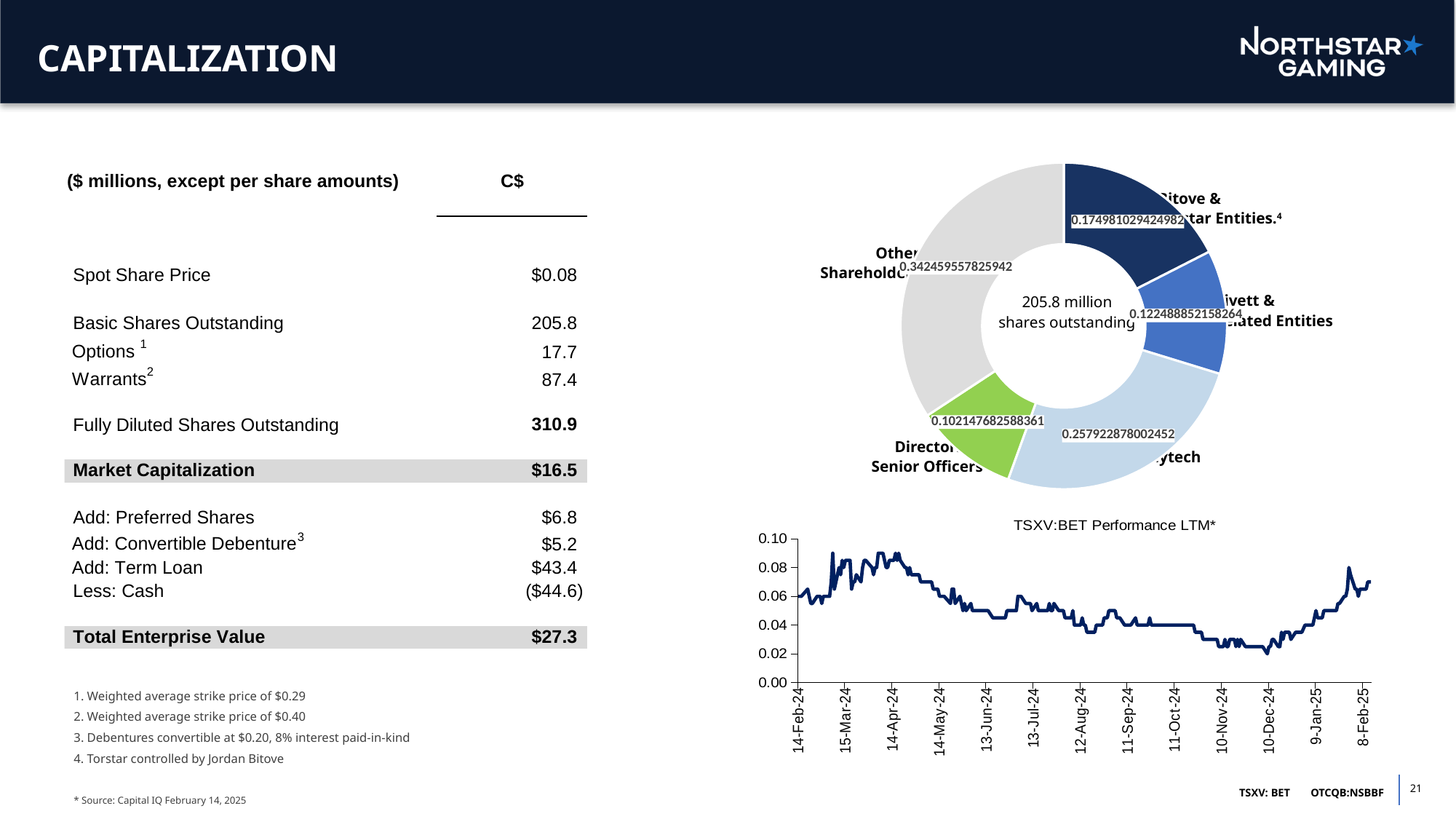
In the doughnut chart at the top right, what text is shown in the centre of the chart? 205.8 million shares outstanding What kind of chart is the chart titled 'TSXV:BET Performance LTM*'? line chart In the doughnut chart at the top right, what is the data label on the Other Shareholders slice? 0.342459557825942 In the doughnut chart at the top right, how many slices are there? 5 In the 'TSXV:BET Performance LTM*' chart, does the line generally rise or fall between 14-Apr-24 and 10-Dec-24? fall In the doughnut chart at the top right, which slice is the smallest? Directors & Senior Officers In the doughnut chart at the top right, which slice is the largest? Other Shareholders In the doughnut chart at the top right, what is the data label on the Directors & Senior Officers slice? 0.102147682588361 In the 'TSXV:BET Performance LTM*' chart, is the value at 14-Apr-24 greater or less than 0.08? greater What kind of chart is the shareholder chart at the top right of the slide? pie chart (doughnut) In the doughnut chart at the top right, which is larger: the Other Shareholders slice or the Directors & Senior Officers slice? Other Shareholders In the 'TSXV:BET Performance LTM*' chart, is the value at 10-Dec-24 greater or less than 0.04? less